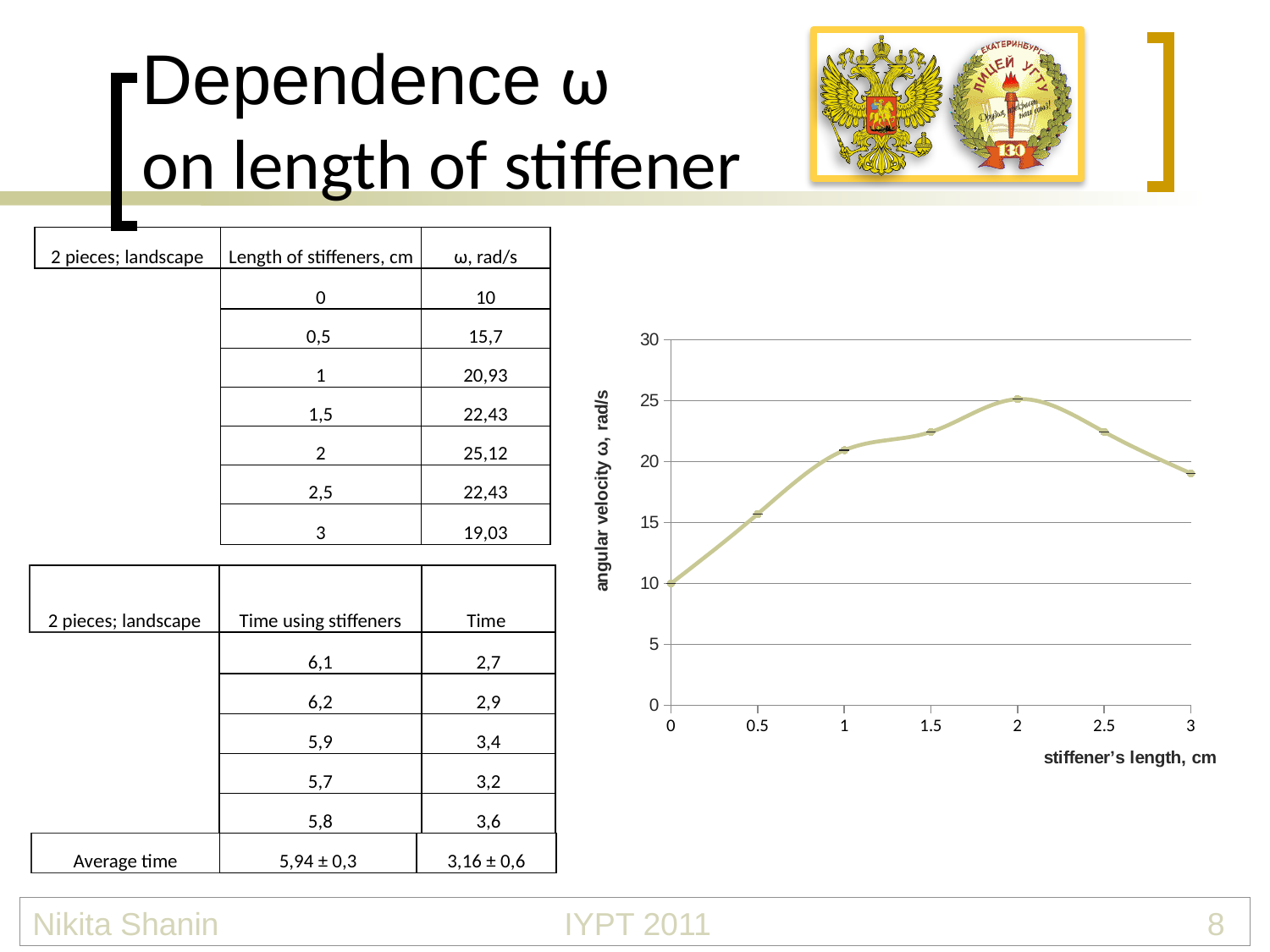
What is the angular velocity at a stiffener's length of 0 cm? 10 Is the angular velocity at a stiffener's length of 1 cm greater or less than 20? greater Which has a higher angular velocity: a stiffener's length of 1 cm or 2.5 cm? 2.5 cm What is the label of the vertical axis of the chart? angular velocity ω, rad/s What kind of chart is shown on the slide? line chart Is the angular velocity at a stiffener's length of 0.5 cm greater or less than 15? greater Is the angular velocity at a stiffener's length of 2 cm greater or less than 25? greater How does the angular velocity change as the stiffener's length increases from 0 to 3 cm? rises up to 2 cm, then falls At which stiffener's length is the angular velocity highest? 2 How many data points are plotted on the chart? 7 At which stiffener's length is the angular velocity lowest? 0